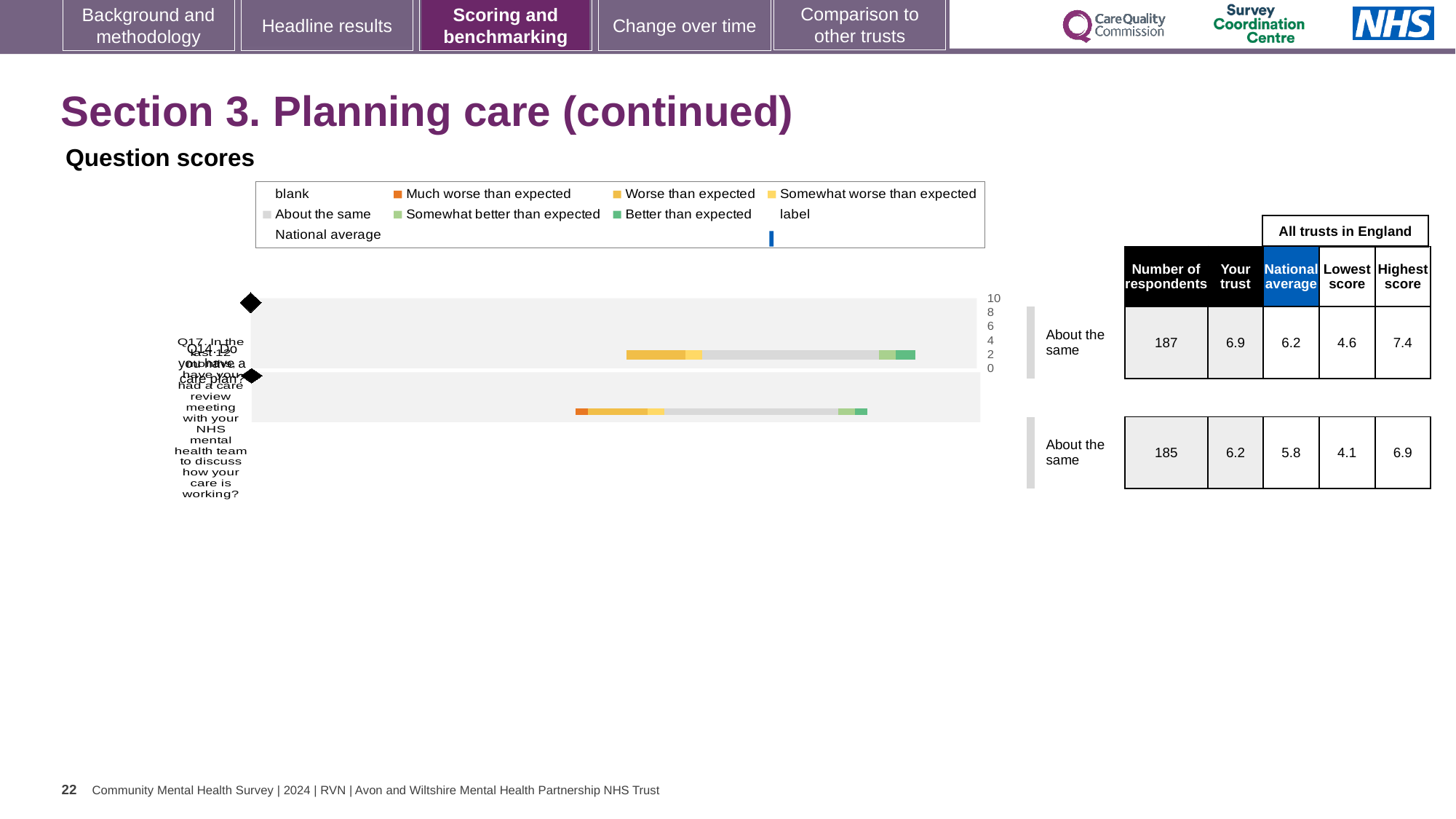
In the table next to the chart, what is the national average for the bottom row? 5.8 For the bottom row, what is the difference between the 'Your trust' score and the national average? 0.4 For the top row, which is larger: the 'Your trust' score or the national average? Your trust How many questions (bars) are plotted in the question scores chart? 2 For the top row, what is the difference between the 'Your trust' score and the national average? 0.7 What kind of chart is used to show the question scores on this slide? bar chart In the table next to the chart, what is the lowest score for the top row? 4.6 In the table next to the chart, what is the 'Your trust' score for the top row? 6.9 In the table next to the chart, what is the highest score for the bottom row? 6.9 In the table next to the chart, what is the number of respondents for the top row? 187 Which row has more respondents, the top row or the bottom row? top row What benchmark category is shown beside the chart for both questions? About the same